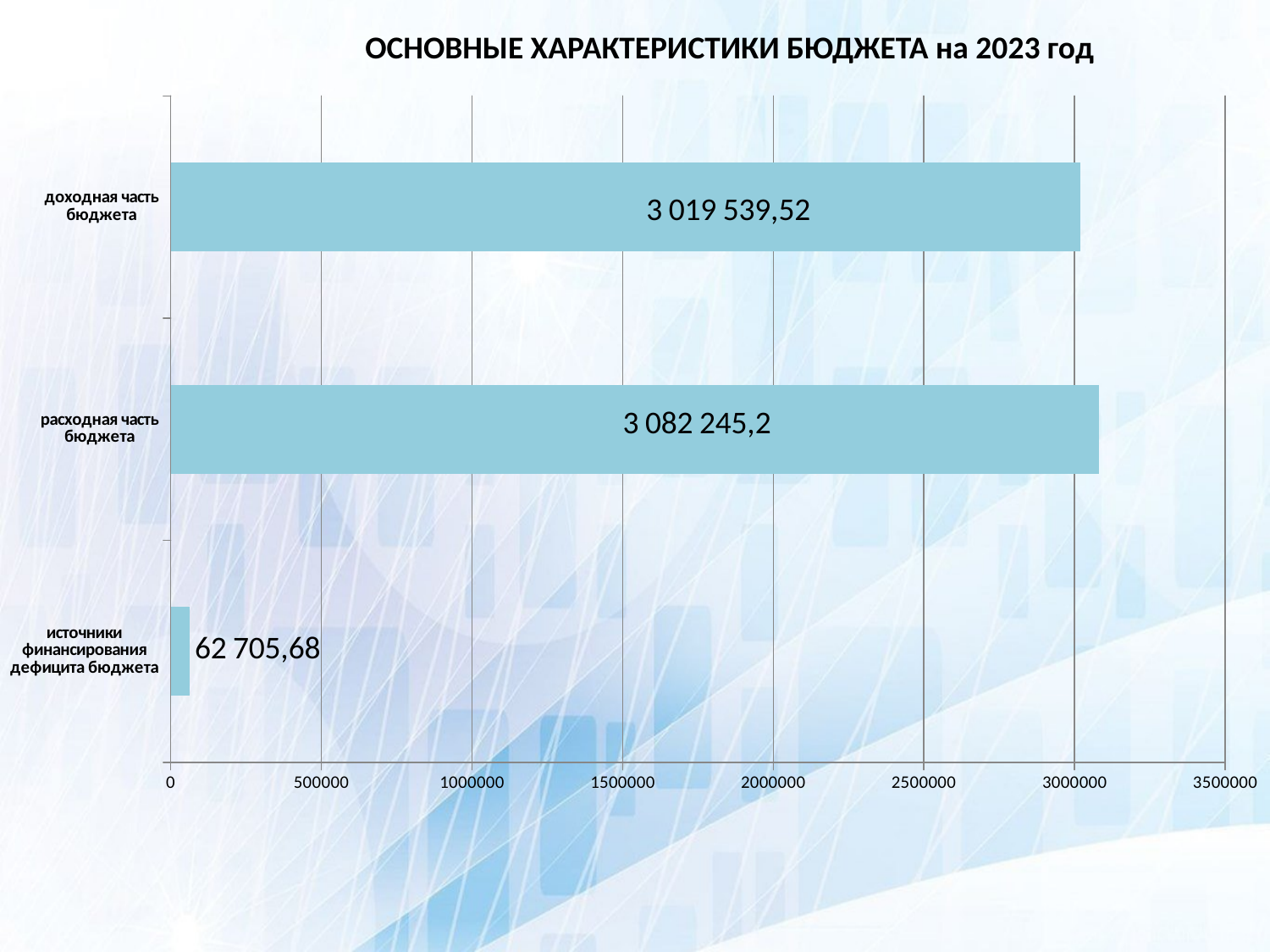
What is the value for доходная часть бюджета? 3 019 539,52 How many categories are shown in the chart? 3 What is the title of the chart? ОСНОВНЫЕ ХАРАКТЕРИСТИКИ БЮДЖЕТА на 2023 год What is the value for источники финансирования дефицита бюджета? 62 705,68 What is the difference between расходная часть бюджета and доходная часть бюджета? 62 705,68 Which is larger, доходная часть бюджета or расходная часть бюджета? расходная часть бюджета Is the value for расходная часть бюджета greater or less than 3000000? greater What is the value for расходная часть бюджета? 3 082 245,2 Is the value for источники финансирования дефицита бюджета greater or less than 500000? less Which category has the lowest value? источники финансирования дефицита бюджета What kind of chart is shown on the slide? bar chart Which category has the highest value? расходная часть бюджета